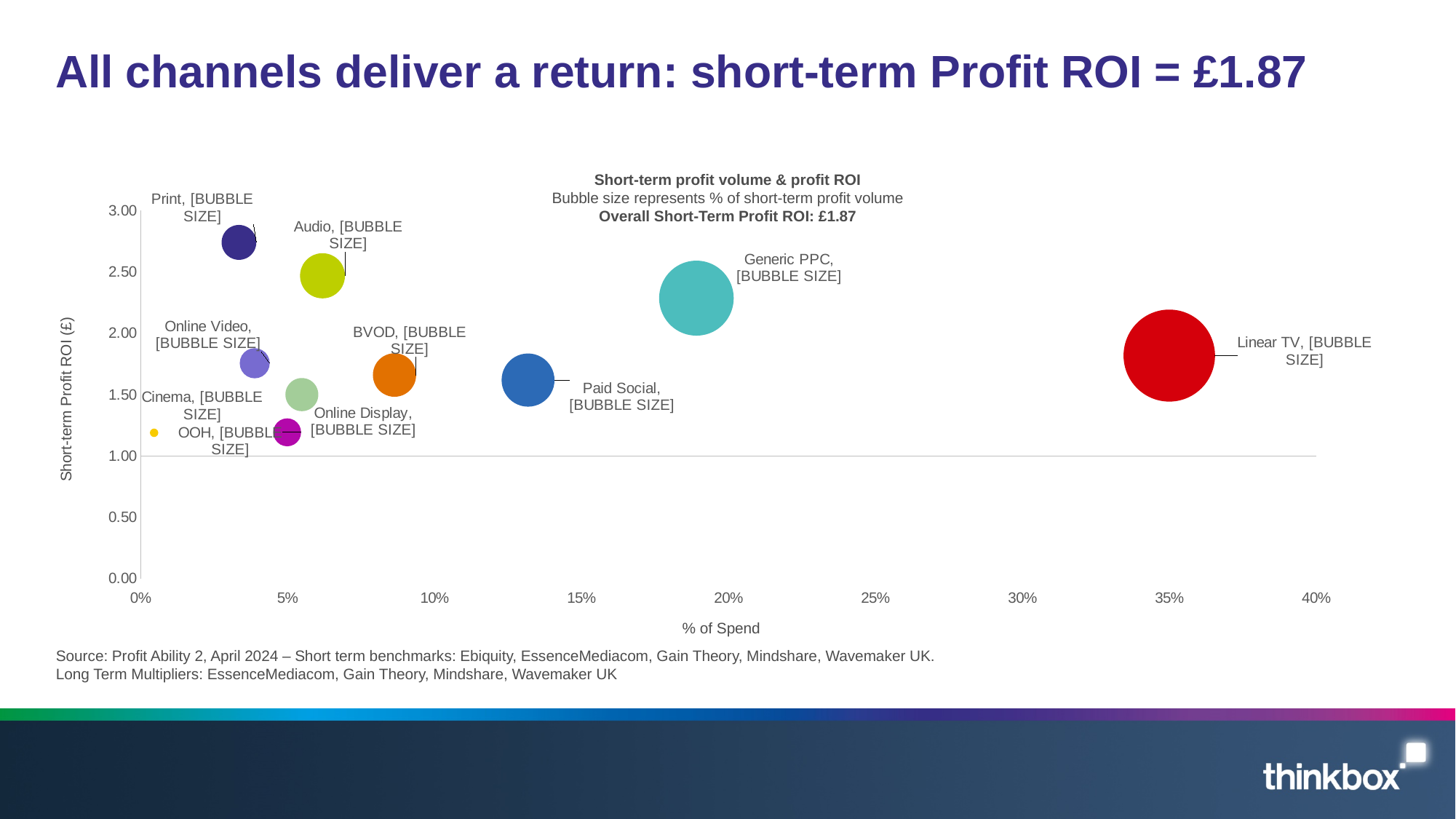
Which channel has the highest short-term profit ROI? Print Is the short-term profit ROI for Paid Social greater or less than 1.50? greater Is the short-term profit ROI for Generic PPC greater or less than 2.00? greater How many channels are plotted as bubbles on the chart? 10 Which channel has the highest % of spend? Linear TV Is the % of spend for Linear TV greater or less than 30%? greater What overall short-term profit ROI is stated in the chart's subtitle? £1.87 What kind of chart is shown on the slide? Bubble chart Which has the larger % of spend, Generic PPC or Linear TV? Linear TV Which has the higher short-term profit ROI, Print or Audio? Print